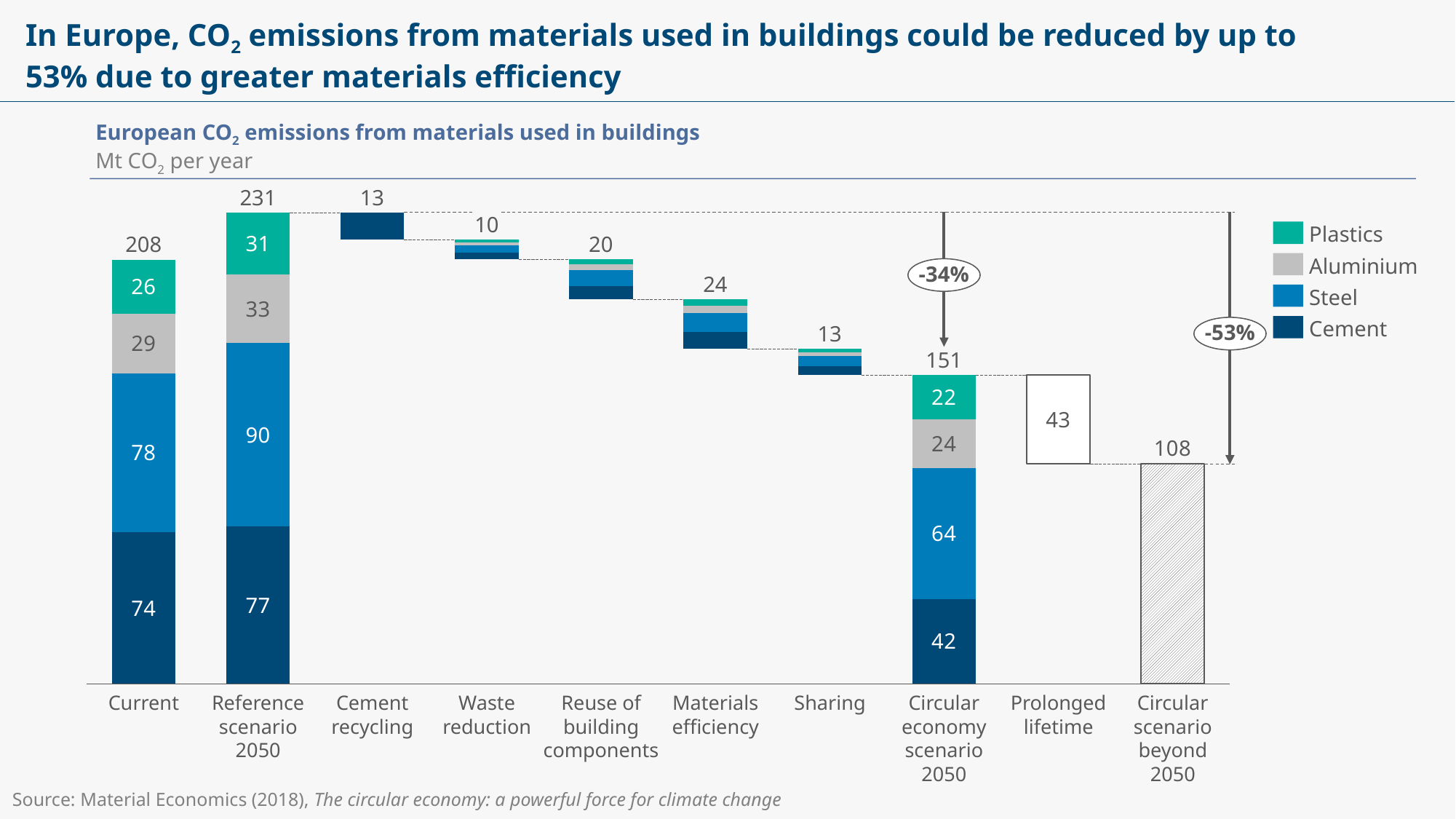
Which is larger, the Cement value in the Current bar or the Cement value in the Circular economy scenario 2050 bar? Current What is the difference between the Reference scenario 2050 total and the Circular scenario beyond 2050 value? 123 Which category has the highest total value? Reference scenario 2050 What kind of chart is this? Stacked bar (waterfall) chart What is the value shown for Materials efficiency? 24 What is the total value shown for the Current bar? 208 What is the Steel value in the Circular economy scenario 2050 bar? 64 What is the total value shown for the Reference scenario 2050 bar? 231 What is the value shown for Prolonged lifetime? 43 What percentage reduction is annotated between the Reference scenario 2050 and the Circular scenario beyond 2050? -53% How many categories are shown on the x axis? 10 How many series does the legend list? 4